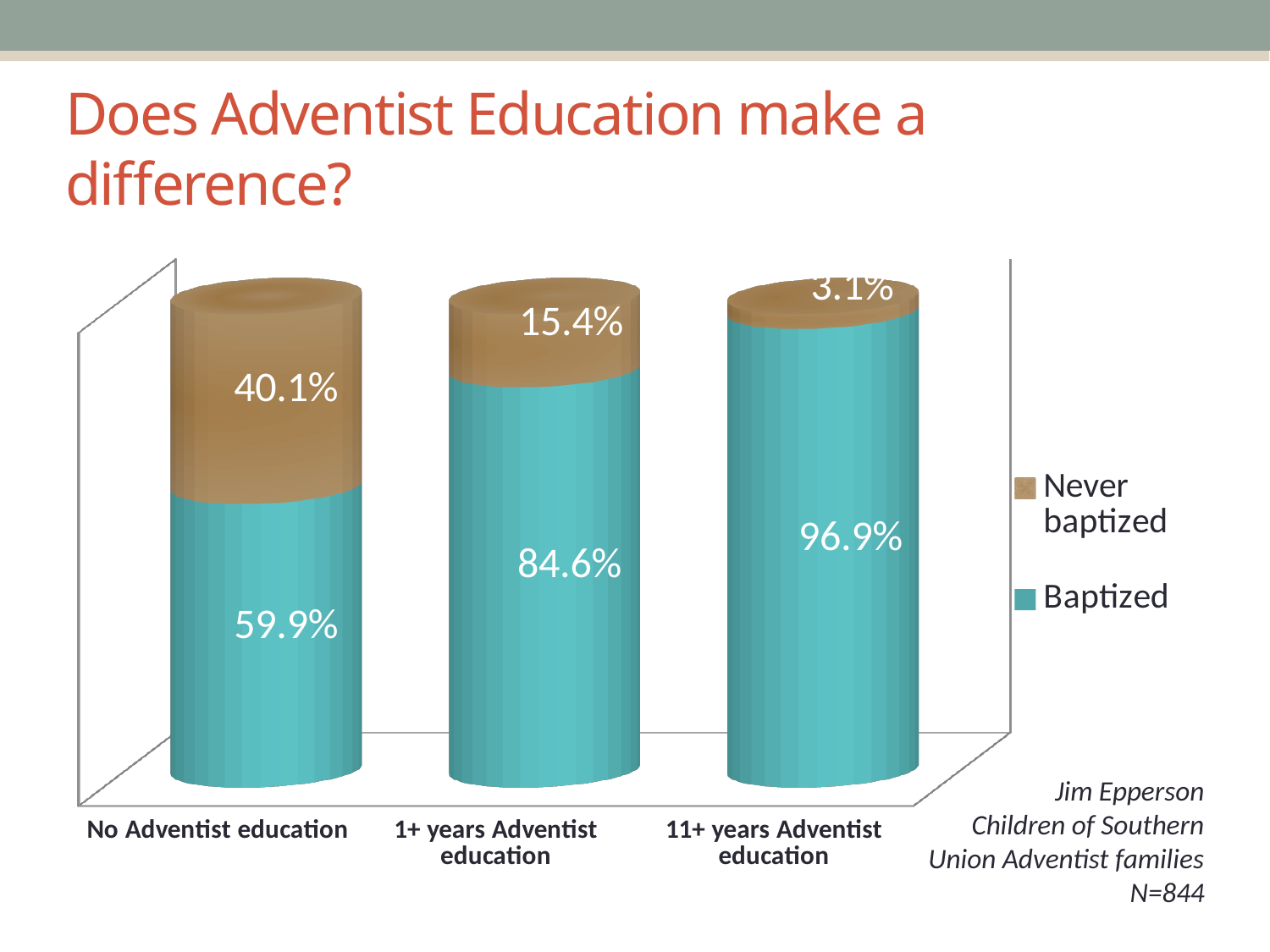
Which category has the highest Baptized value? 11+ years Adventist education Does the Baptized value rise or fall from No Adventist education to 11+ years Adventist education? Rise Which category has the lowest Never baptized value? 11+ years Adventist education What is the Never baptized value for 11+ years Adventist education? 3.1% What kind of chart is shown on the slide? Stacked bar chart How many series does the legend list? 2 Is the Never baptized value larger for No Adventist education or for 1+ years Adventist education? No Adventist education What is the Baptized value for 11+ years Adventist education? 96.9% How many categories are shown on the x axis? 3 What is the Never baptized value for 1+ years Adventist education? 15.4% What is the difference between the Baptized values for 1+ years Adventist education and No Adventist education? 24.7% What is the Baptized value for No Adventist education? 59.9%